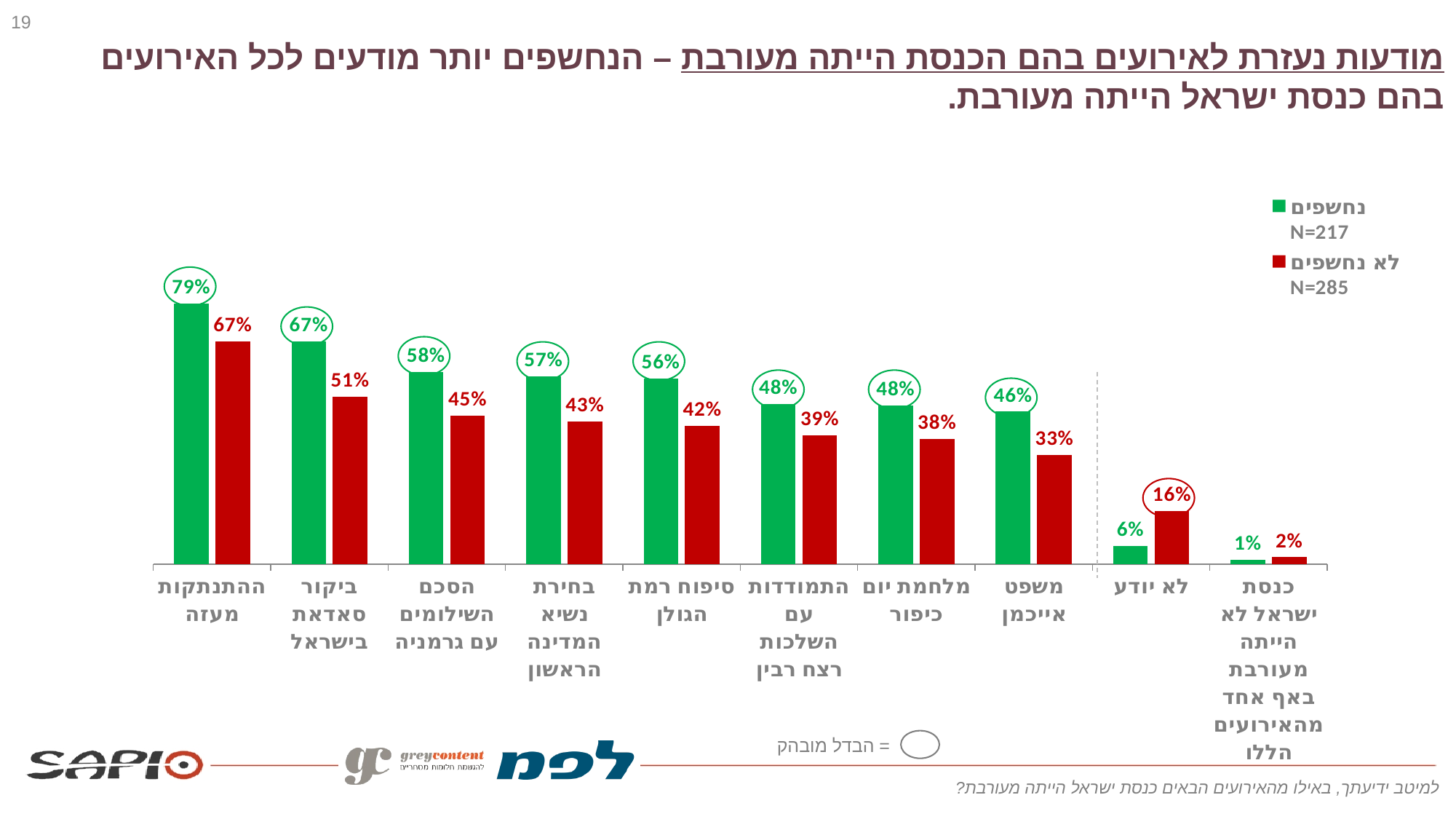
What is the value for לא נחשפים for לא יודע? 16% What is the value for נחשפים for ההתנתקות מעזה? 79% What kind of chart is shown on the slide? bar chart How many categories are shown on the x axis? 10 Which category has the lowest value for לא נחשפים? כנסת ישראל לא הייתה מעורבת באף אחד מהאירועים הללו Which colour represents the נחשפים series? green For לא יודע, which series has the larger value, נחשפים or לא נחשפים? לא נחשפים What is the difference between the נחשפים and לא נחשפים values for ביקור סאדאת בישראל? 16% What is the value for לא נחשפים for משפט אייכמן? 33% How many series does the legend list? 2 Which category has the highest value for נחשפים? ההתנתקות מעזה What is the sample size (N) shown in the legend for לא נחשפים? N=285